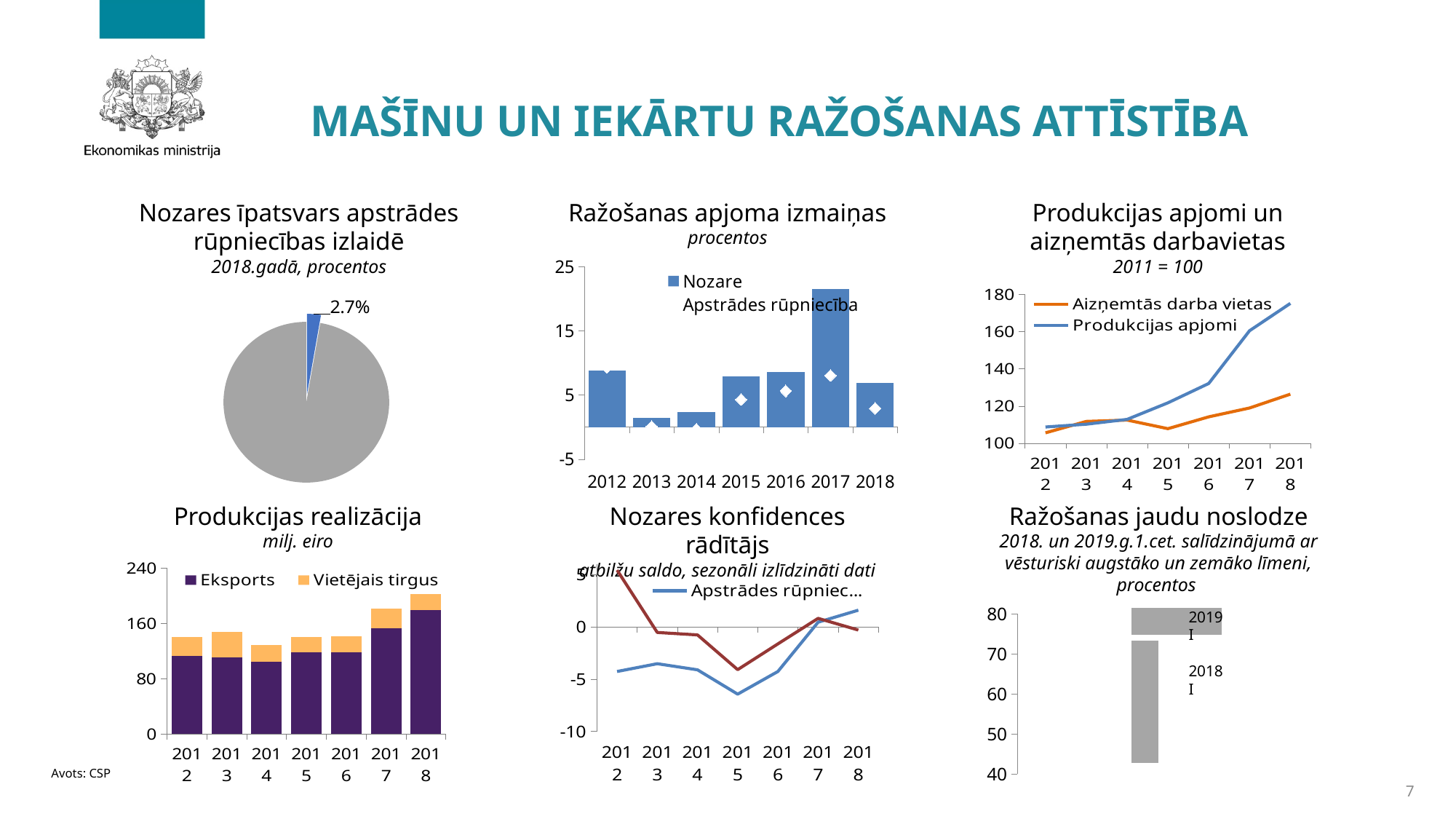
In the chart titled 'Ražošanas apjoma izmaiņas', which year has the lowest bar for Nozare? 2013 In the chart titled 'Produkcijas apjomi un aizņemtās darbavietas', which series is higher in 2018, Aizņemtās darba vietas or Produkcijas apjomi? Produkcijas apjomi In the chart titled 'Produkcijas realizācija', which year has the highest Eksports bar? 2018 In the chart titled 'Produkcijas apjomi un aizņemtās darbavietas', does the Produkcijas apjomi line rise or fall from 2014 to 2018? rise In the chart titled 'Nozares īpatsvars apstrādes rūpniecības izlaidē', what share is shown for the highlighted slice? 2.7% In the chart titled 'Nozares konfidences rādītājs', is the Apstrādes rūpniecība value for 2015 greater or less than -5? less How many series does the legend list in the chart titled 'Produkcijas realizācija'? 2 In the chart titled 'Ražošanas apjoma izmaiņas', which year has the highest bar for Nozare? 2017 In the chart titled 'Produkcijas apjomi un aizņemtās darbavietas', is the Produkcijas apjomi value for 2018 greater or less than 160? greater In the chart titled 'Ražošanas apjoma izmaiņas', is the Nozare value for 2017 greater or less than 15? greater What kind of chart is 'Nozares īpatsvars apstrādes rūpniecības izlaidē'? pie chart How many years are shown on the x axis of the chart titled 'Ražošanas apjoma izmaiņas'? 7